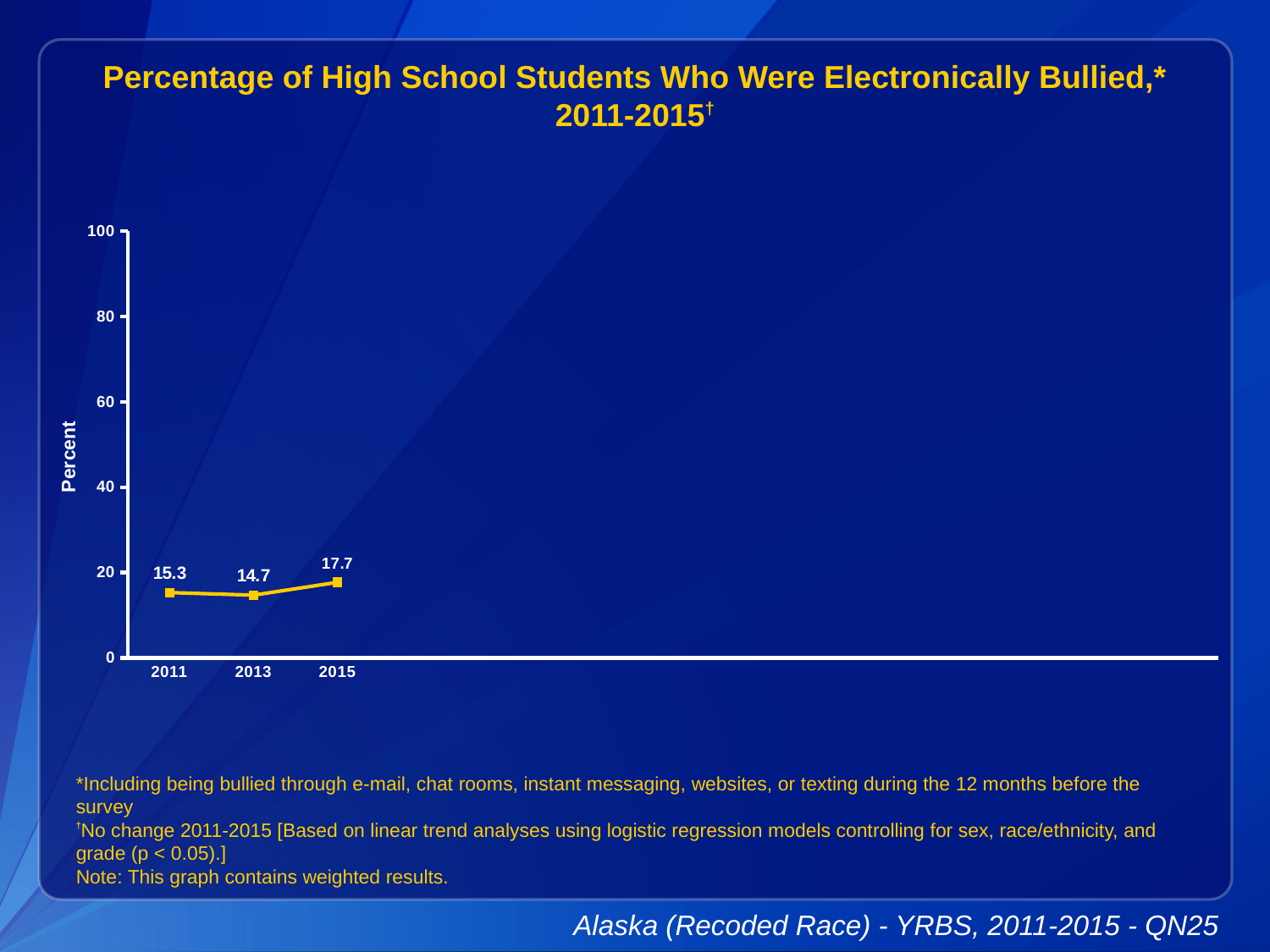
What is the label of the y axis? Percent Which year has the highest value? 2015 What is the value for 2013? 14.7 What is the value for 2015? 17.7 What is the difference between the values for 2015 and 2011? 2.4 What is the difference between the values for 2011 and 2013? 0.6 Which year has the lowest value? 2013 How many years are plotted on the chart? 3 What is the value for 2011? 15.3 Is the value for 2015 greater or less than 20? less What kind of chart is shown on the slide? line chart Which is larger, the value for 2013 or the value for 2015? 2015